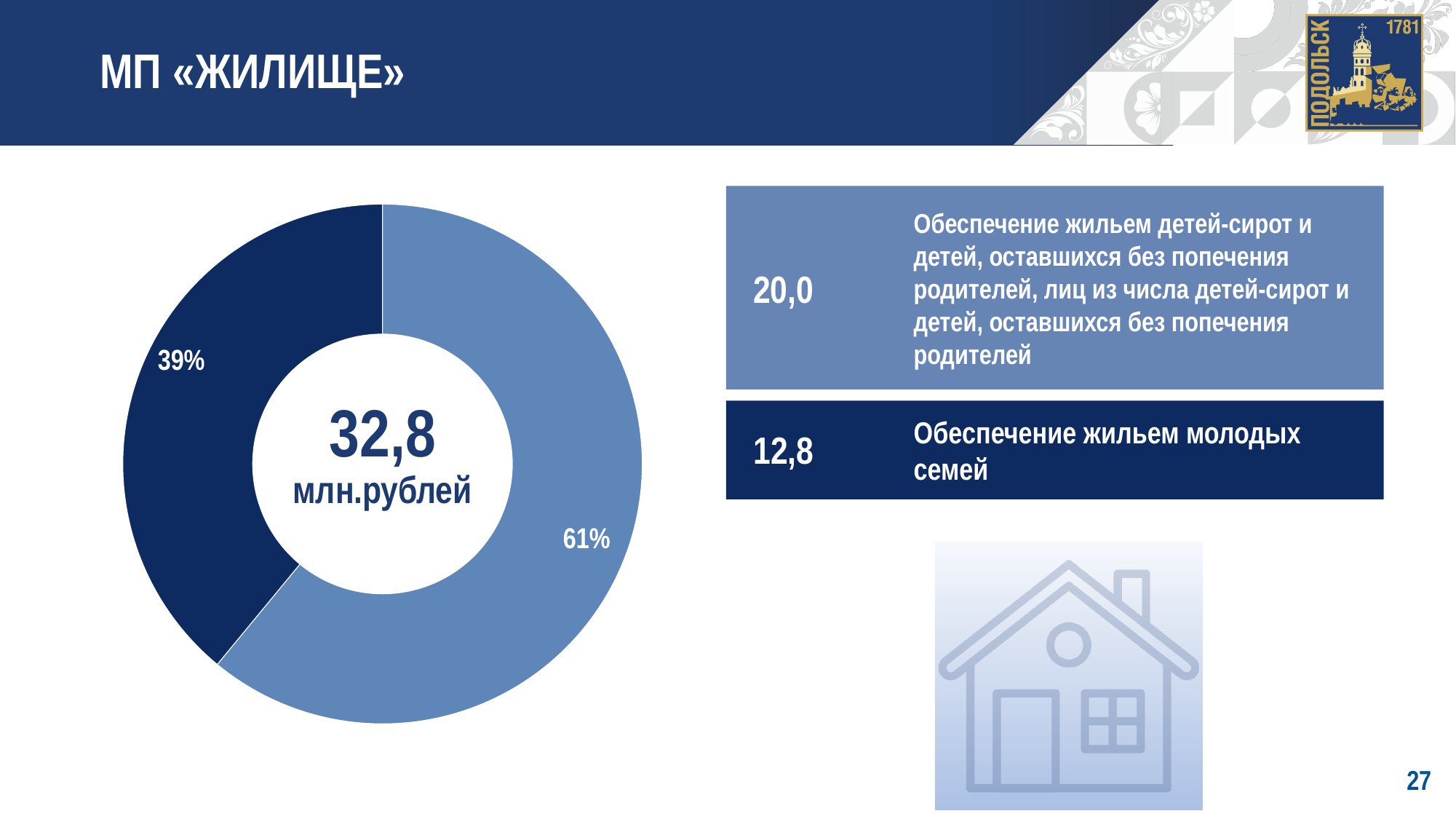
What is the difference between the values 20,0 and 12,8 shown for the two categories? 7,2 What share of the donut chart does the light blue slice represent? 61% What total value is printed in the centre of the donut chart? 32,8 млн.рублей What share of the donut chart does the dark blue slice represent? 39% How many slices does the donut chart have? 2 By how many percentage points does the 61% slice exceed the 39% slice? 22 Which category has the larger value: «Обеспечение жильем детей-сирот...» or «Обеспечение жильем молодых семей»? Обеспечение жильем детей-сирот... What colour is the slice for «Обеспечение жильем молодых семей»? Dark blue What is the value for «Обеспечение жильем детей-сирот и детей, оставшихся без попечения родителей...»? 20,0 Which category has the smallest share of the donut chart? Обеспечение жильем молодых семей What kind of chart is shown on the slide? Pie chart (donut) What is the value for «Обеспечение жильем молодых семей»? 12,8